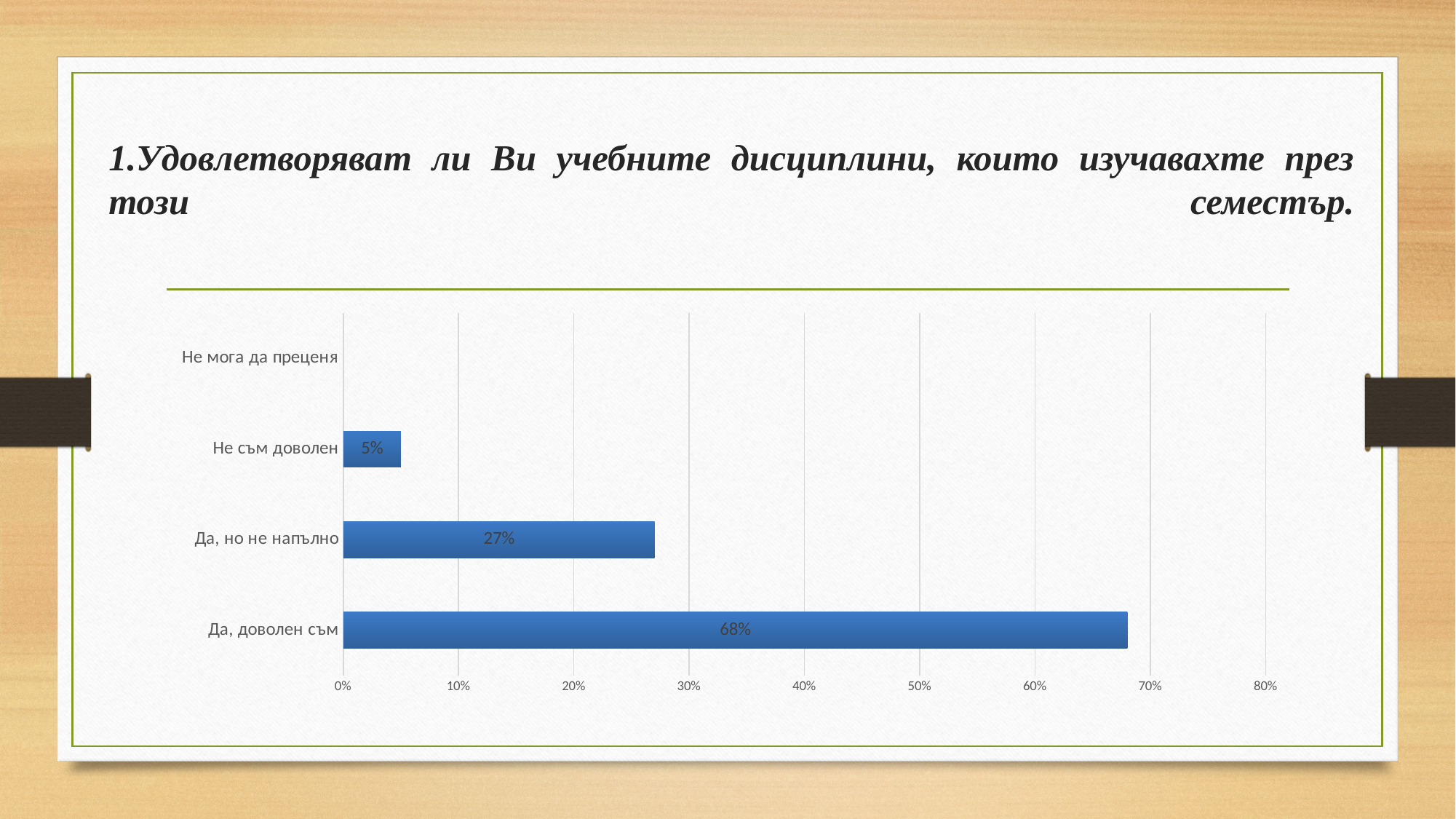
What kind of chart is shown on the slide? Bar chart What is the difference between the values for "Да, но не напълно" and "Не съм доволен"? 22% Is the value for "Да, но не напълно" greater or less than 30%? less Which is larger, the value for "Да, но не напълно" or the value for "Не съм доволен"? Да, но не напълно Is the value for "Да, доволен съм" greater or less than 60%? greater What is the highest value shown on the horizontal axis of the chart? 80% What is the difference between the values for "Да, доволен съм" and "Да, но не напълно"? 41% What is the value for "Да, доволен съм"? 68% What is the value for "Да, но не напълно"? 27% Which category has the highest value? Да, доволен съм How many categories are shown on the chart? 4 What is the value for "Не съм доволен"? 5%